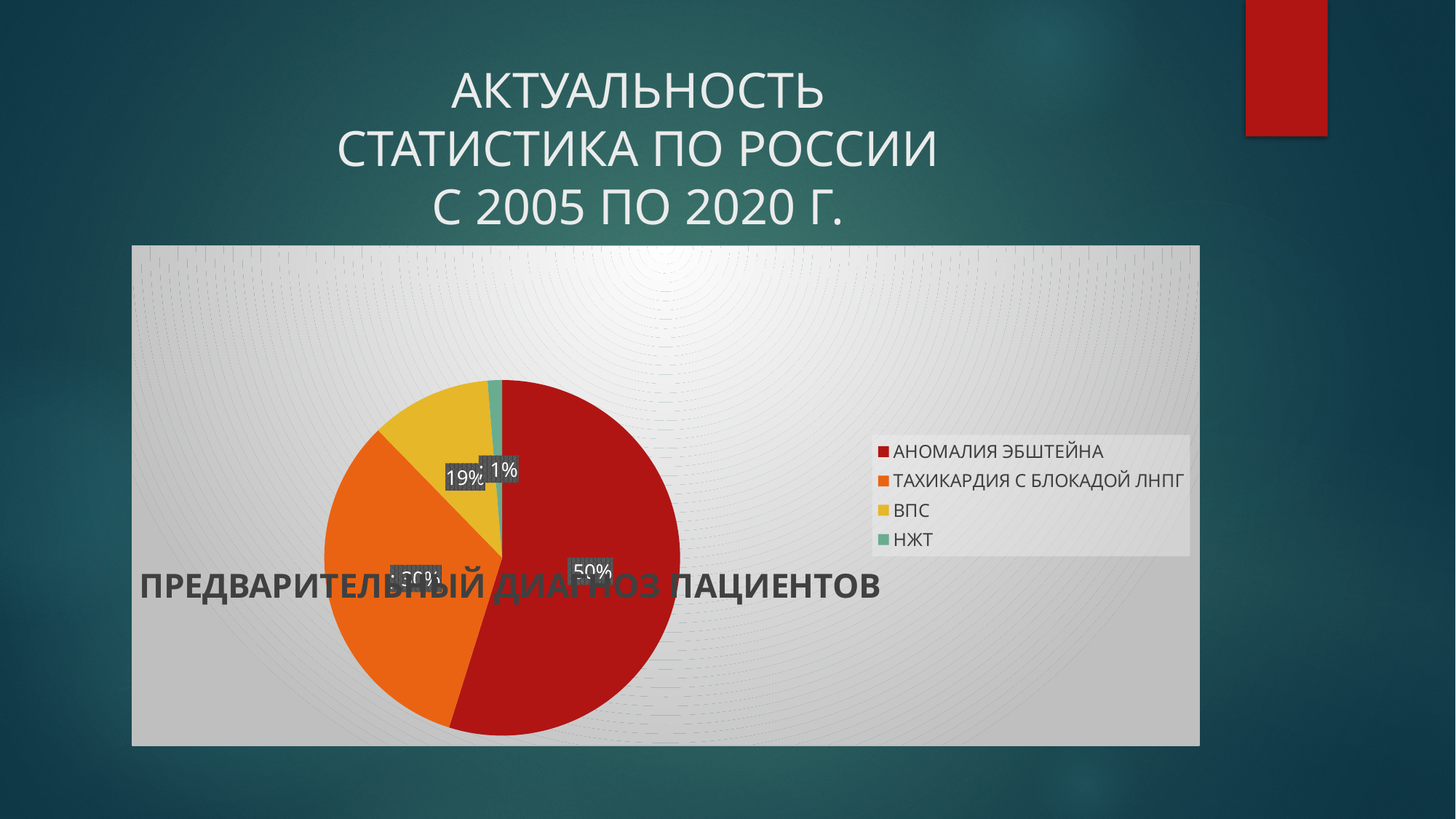
What percentage is shown for НЖТ in the pie chart? 1% How many slices does the pie chart have? 4 What colour is the АНОМАЛИЯ ЭБШТЕЙНА slice in the pie chart? red Which category has the largest slice in the pie chart? АНОМАЛИЯ ЭБШТЕЙНА How many entries does the legend of the pie chart list? 4 What percentage is shown for ВПС in the pie chart? 19% Which slice is larger in the pie chart, ВПС or НЖТ? ВПС What is the title of the pie chart? ПРЕДВАРИТЕЛЬНЫЙ ДИАГНОЗ ПАЦИЕНТОВ What percentage is shown for АНОМАЛИЯ ЭБШТЕЙНА in the pie chart? 50% Which category has the smallest slice in the pie chart? НЖТ What kind of chart is shown on the slide? pie chart By how many percentage points does the АНОМАЛИЯ ЭБШТЕЙНА slice exceed the ВПС slice? 31 percentage points